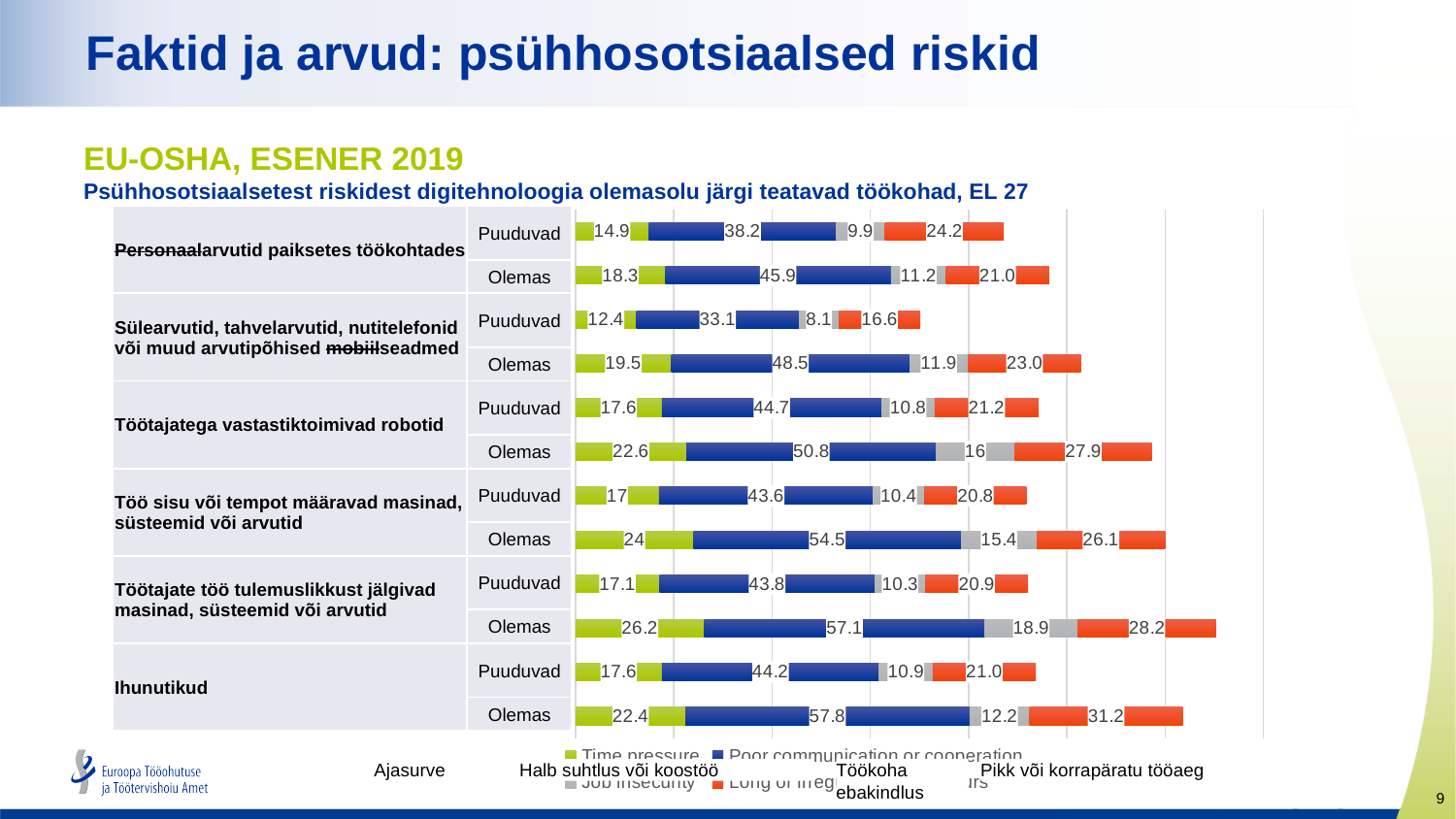
For Ihunutikud, what is the difference in the Halb suhtlus või koostöö value between the Olemas and Puuduvad bars? 13.6 What kind of chart is shown on the slide? Stacked horizontal bar chart What is the Pikk või korrapäratu tööaeg value for the Olemas bar of Ihunutikud? 31.2 Which bar has the highest Ajasurve value? Töötajate töö tulemuslikkust jälgivad masinad, süsteemid või arvutid – Olemas What is the Halb suhtlus või koostöö value for the Puuduvad bar of Sülearvutid, tahvelarvutid, nutitelefonid või muud arvutipõhised mobiilseadmed? 33.1 What is the Töökoha ebakindlus value for the Olemas bar of Töötajatega vastastiktoimivad robotid? 16 How many series does the legend list? 4 Which bar has the lowest Halb suhtlus või koostöö value? Sülearvutid, tahvelarvutid, nutitelefonid või muud arvutipõhised mobiilseadmed – Puuduvad What is the total of the Puuduvad bar for Sülearvutid, tahvelarvutid, nutitelefonid või muud arvutipõhised mobiilseadmed? 70.2 What is the Ajasurve value for the Olemas bar of Töötajate töö tulemuslikkust jälgivad masinad, süsteemid või arvutid? 26.2 For Personaalarvutid paiksetes töökohtades, which bar has the larger Pikk või korrapäratu tööaeg value, Puuduvad or Olemas? Puuduvad How many bars are plotted in the chart? 12